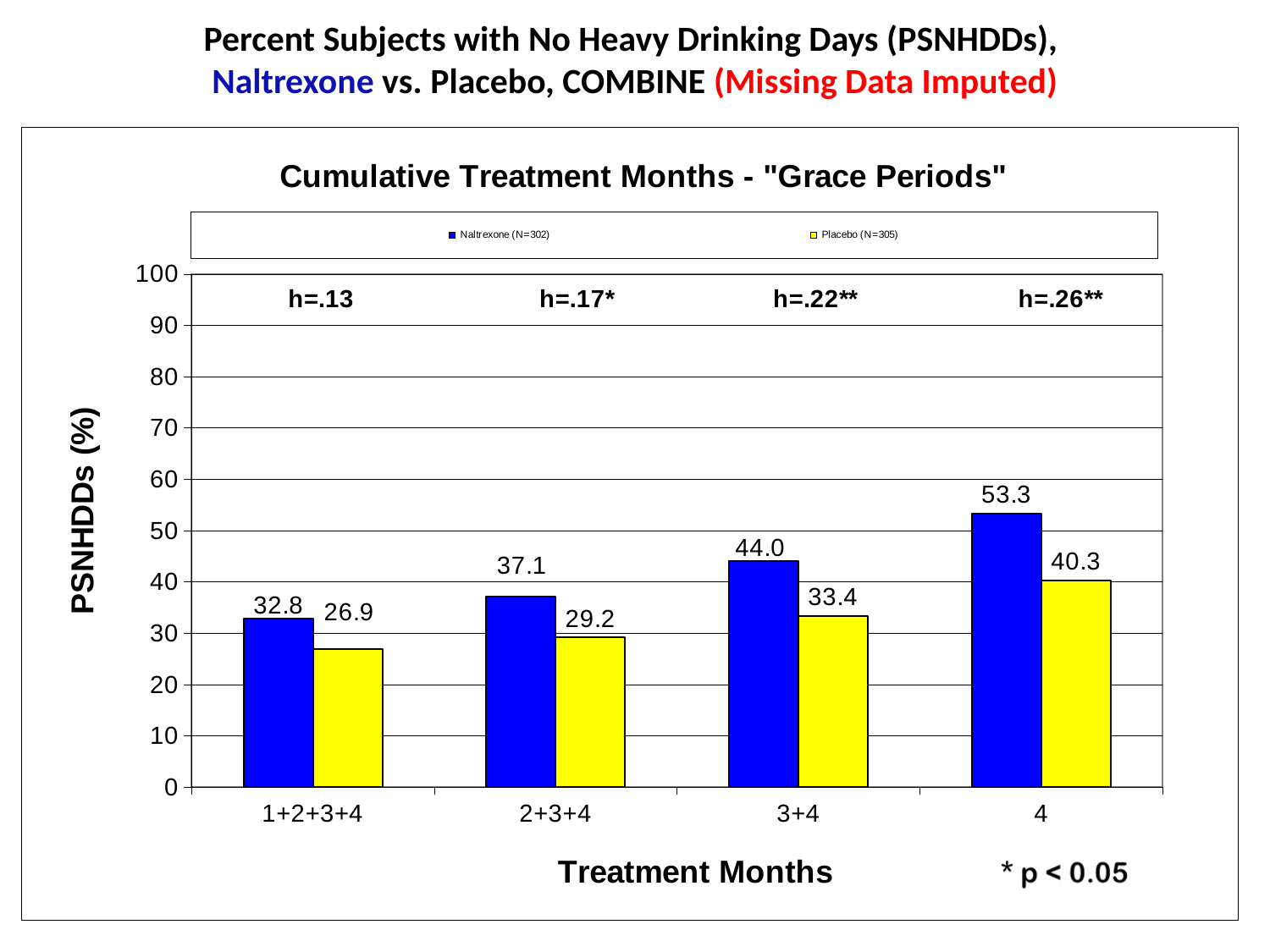
What kind of chart is shown? bar chart Which is larger for the 2+3+4 category, Naltrexone or Placebo? Naltrexone Which category has the highest Naltrexone value? 4 How many series does the legend list? 2 What is the Naltrexone value for the 1+2+3+4 treatment months category? 32.8 Which category has the lowest Placebo value? 1+2+3+4 How many treatment months categories are shown on the x axis? 4 Is the Naltrexone value for the 4 category greater or less than 50? greater What is the difference between the Naltrexone and Placebo values for the 3+4 category? 10.6 Do the Naltrexone values rise or fall from 1+2+3+4 to 4 along the x axis? rise What is the Placebo value for the 2+3+4 category? 29.2 What is the Placebo value for the 4 treatment months category? 40.3